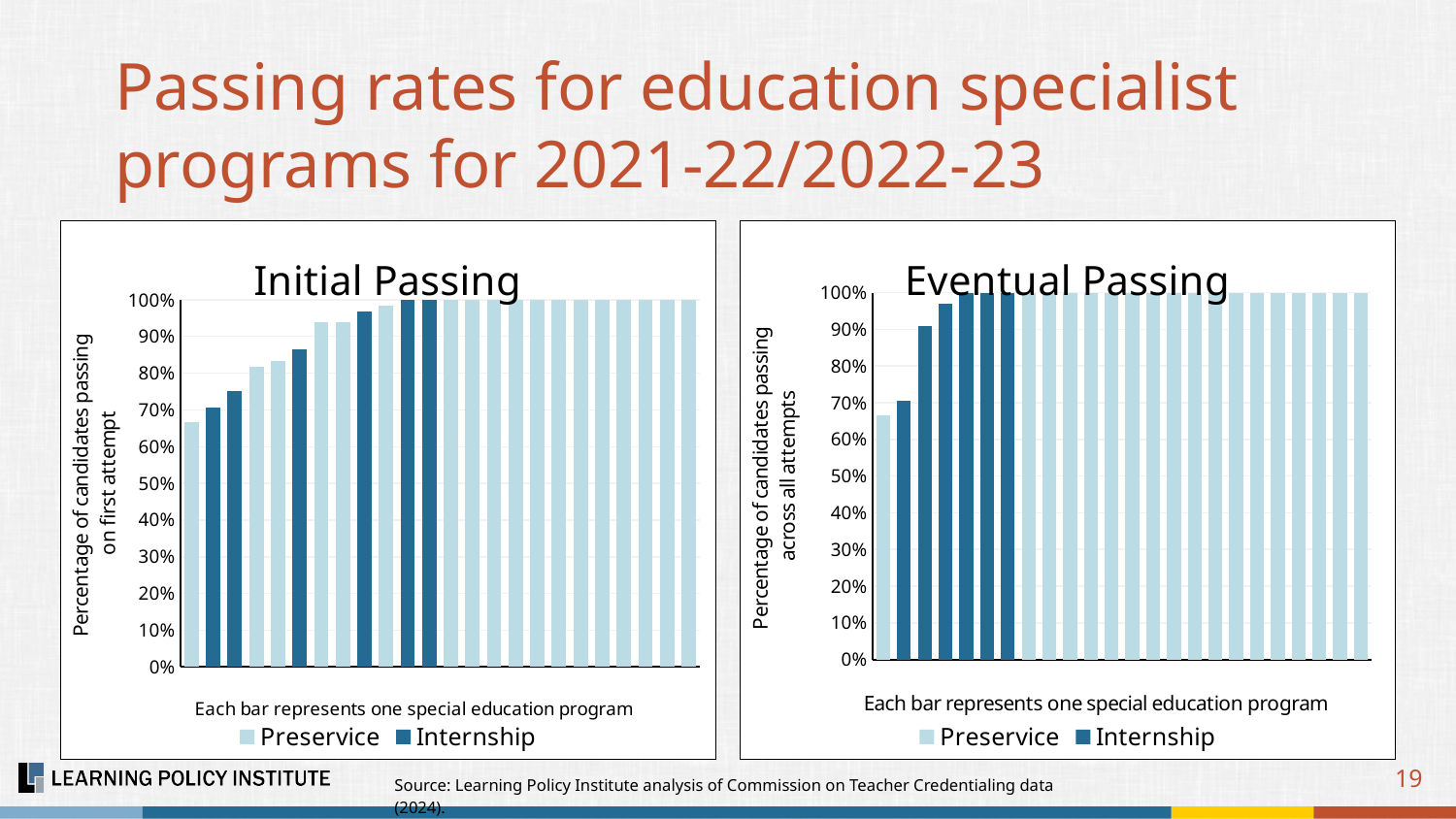
In the Initial Passing chart, is the value for the leftmost bar greater or less than 70%? less What is the y-axis label of the Eventual Passing chart? Percentage of candidates passing across all attempts What kind of chart is the Initial Passing chart? Bar chart In the Initial Passing chart, is the value for the third bar from the left greater or less than 80%? less What are the two series named in the legend of the Initial Passing chart? Preservice and Internship In the Eventual Passing chart, which is larger: the leftmost bar or the rightmost bar? The rightmost bar In the Initial Passing chart, is the value for the rightmost bar greater or less than 90%? greater In the Initial Passing chart, which bar is the lowest: the leftmost or the rightmost? The leftmost How many series does the legend of the Eventual Passing chart list? 2 In the Initial Passing chart, do the bar values rise or fall from left to right? Rise In the Eventual Passing chart, do the bar values rise or fall from left to right? Rise